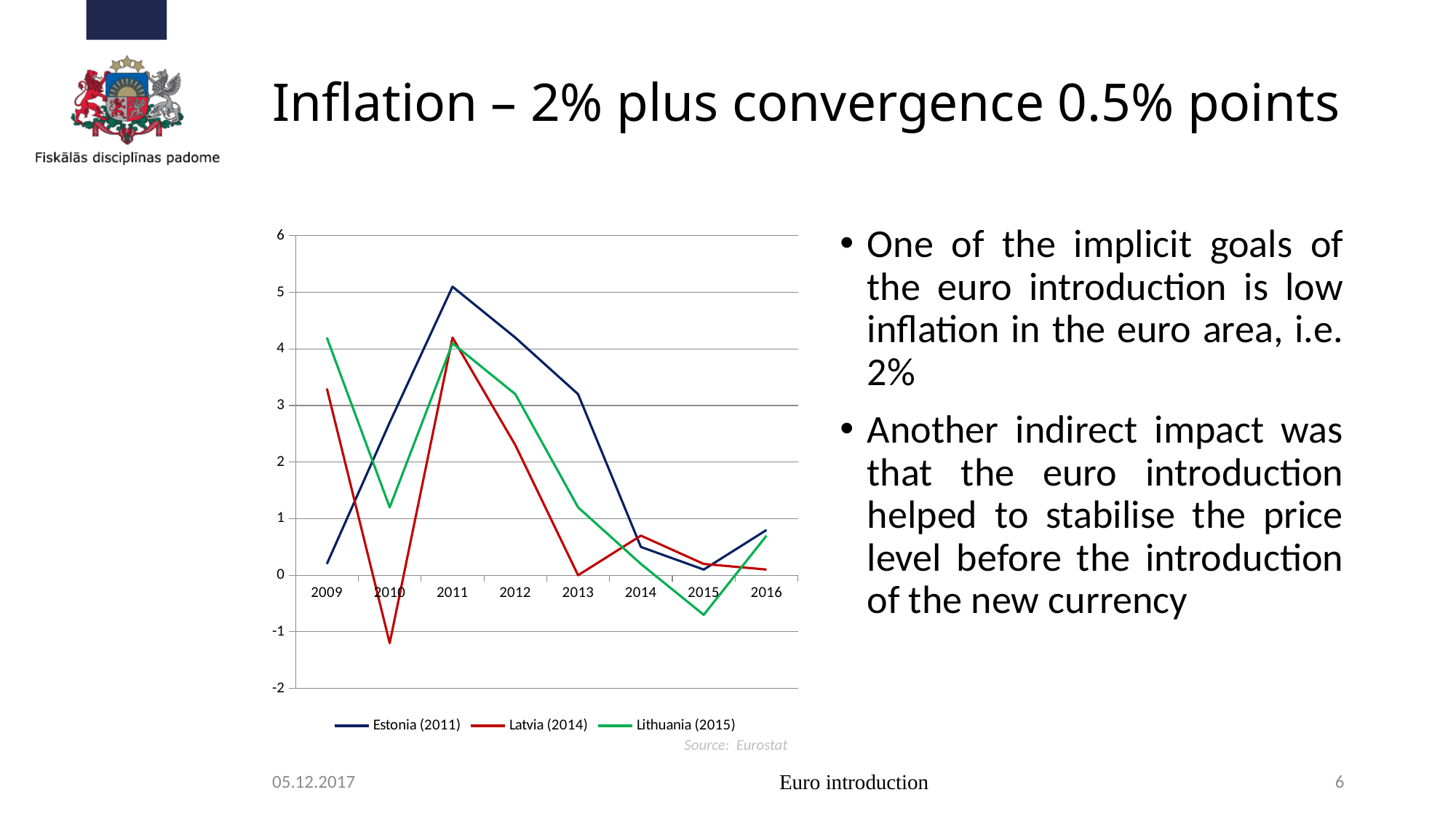
In which year does the Latvia (2014) line reach its lowest value? 2010 In 2009, which series has the higher value: Lithuania (2015) or Estonia (2011)? Lithuania (2015) In 2010, which series has the higher value: Estonia (2011) or Latvia (2014)? Estonia (2011) How many years are plotted along the x axis of the chart? 8 Is the value for Latvia (2014) in 2010 greater or less than 0? less In which year does the Lithuania (2015) line reach its lowest value? 2015 In which year does the Estonia (2011) line reach its highest value? 2011 Does the Estonia (2011) line rise or fall between 2011 and 2015? fall Is the value for Estonia (2011) in 2011 greater or less than 4? greater How many series does the chart legend list? 3 Is the value for Lithuania (2015) in 2015 greater or less than 0? less What kind of chart is shown on the slide? line chart